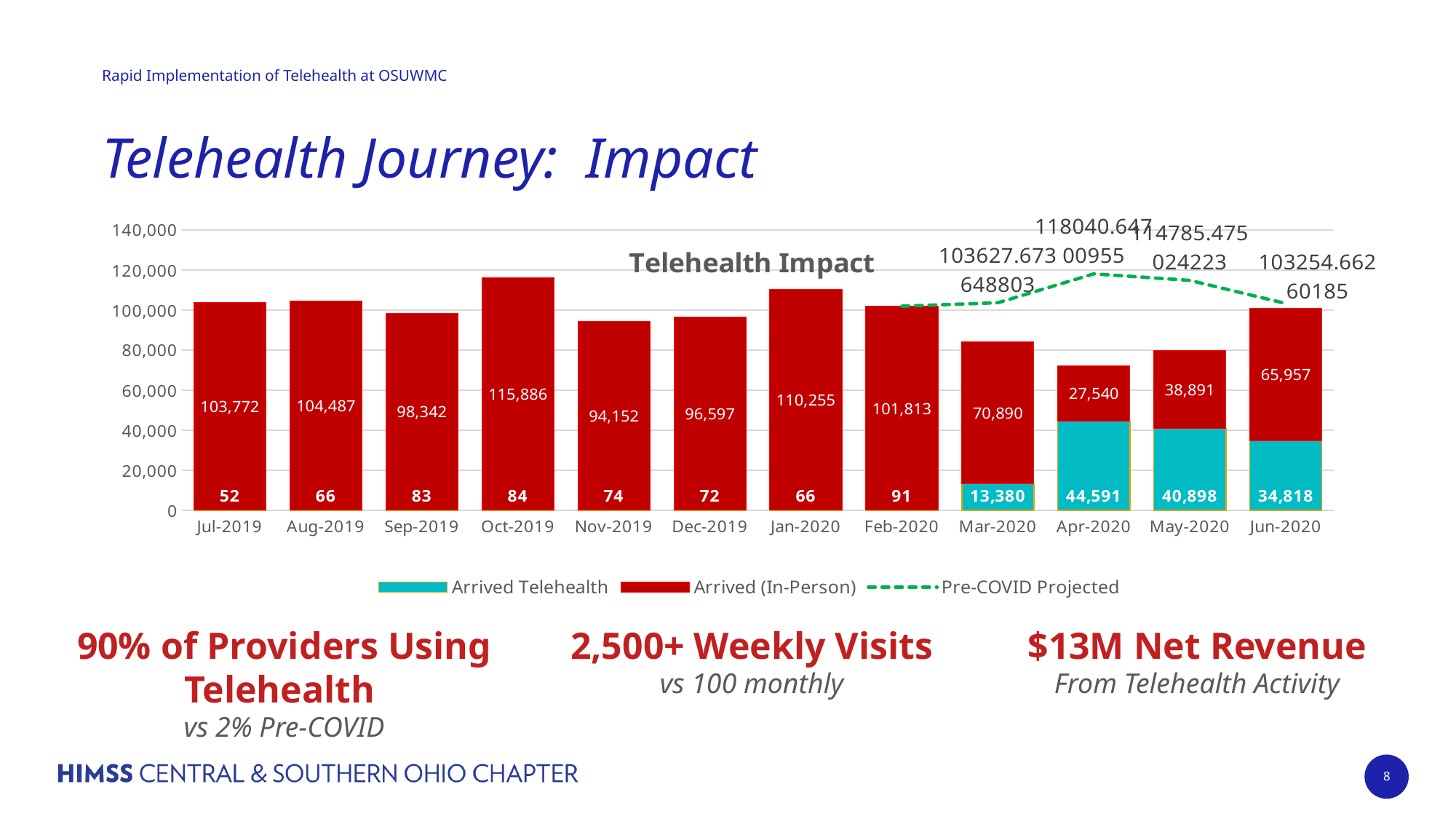
What is the Arrived (In-Person) value for Oct-2019? 115,886 What is the difference between the Arrived (In-Person) values for Feb-2020 and Mar-2020? 30,923 Which month has the highest Arrived (In-Person) value? Oct-2019 What is the Arrived Telehealth value for Apr-2020? 44,591 What is the total of the stacked bar for Apr-2020 (Arrived Telehealth plus Arrived (In-Person))? 72,131 Does the Arrived (In-Person) value rise or fall from Feb-2020 to Apr-2020? fall What is the Arrived (In-Person) value for Jun-2020? 65,957 Which month has the lowest Arrived (In-Person) value? Apr-2020 Which is larger, the Arrived (In-Person) value for Jan-2020 or for Feb-2020? Jan-2020 How many months are shown on the x axis of the chart? 12 How many series does the chart legend list? 3 Which month has the highest Arrived Telehealth value? Apr-2020